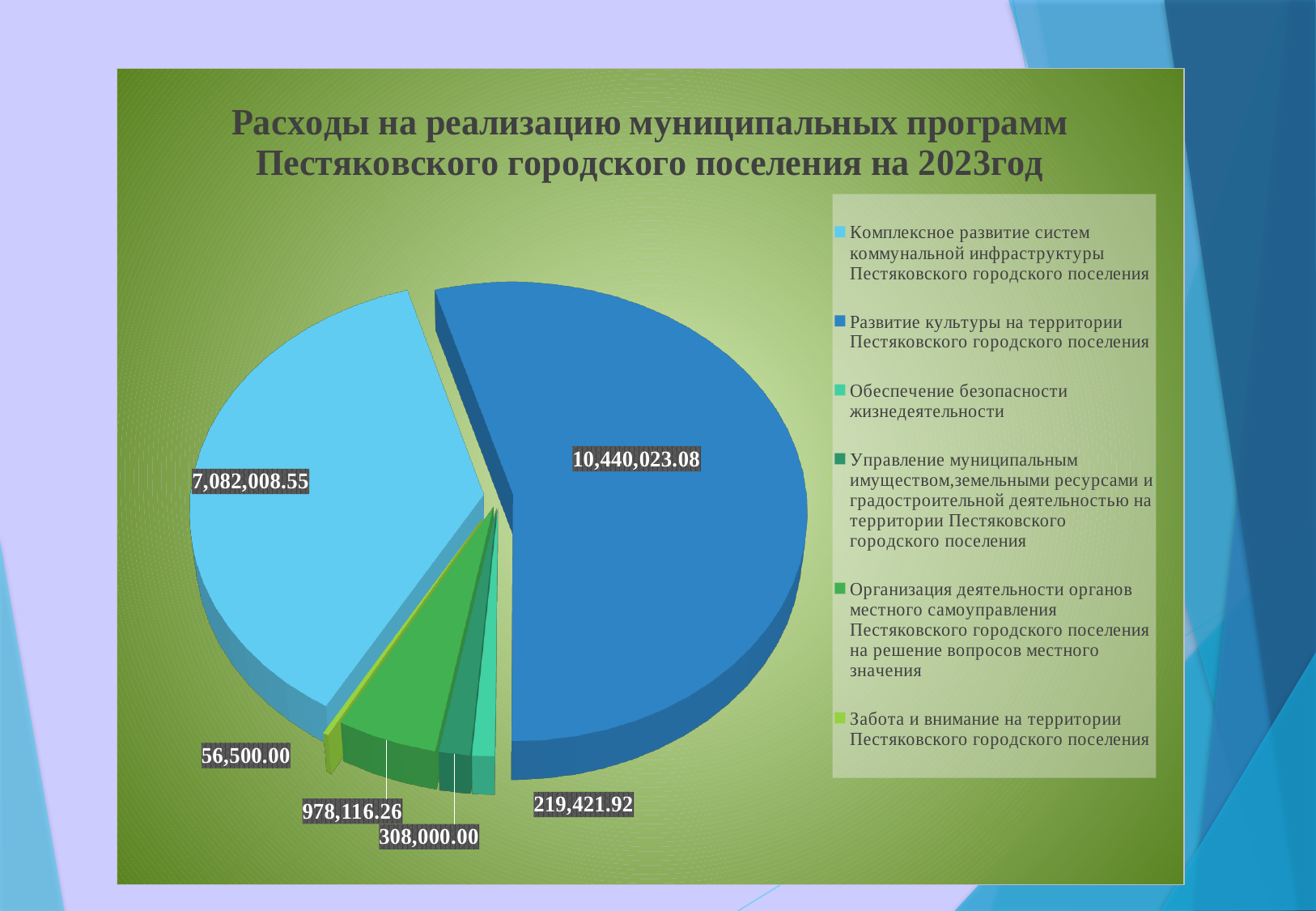
Which program has the largest share of expenses in the pie chart? Развитие культуры на территории Пестяковского городского поселения How many slices does the pie chart have? 6 What is the title of the chart? Расходы на реализацию муниципальных программ Пестяковского городского поселения на 2023год What is the value for Организация деятельности органов местного самоуправления Пестяковского городского поселения на решение вопросов местного значения? 978,116.26 Which program has the smallest share of expenses in the pie chart? Забота и внимание на территории Пестяковского городского поселения Which is larger: the value for Организация деятельности органов местного самоуправления or the value for Забота и внимание? Организация деятельности органов местного самоуправления How many entries does the legend list? 6 What is the difference between the value for Развитие культуры and the value for Комплексное развитие систем коммунальной инфраструктуры? 3,358,014.53 What is the value for Комплексное развитие систем коммунальной инфраструктуры Пестяковского городского поселения? 7,082,008.55 What kind of chart is shown on the slide? Pie chart What is the value for Развитие культуры на территории Пестяковского городского поселения? 10,440,023.08 What is the value for Забота и внимание на территории Пестяковского городского поселения? 56,500.00